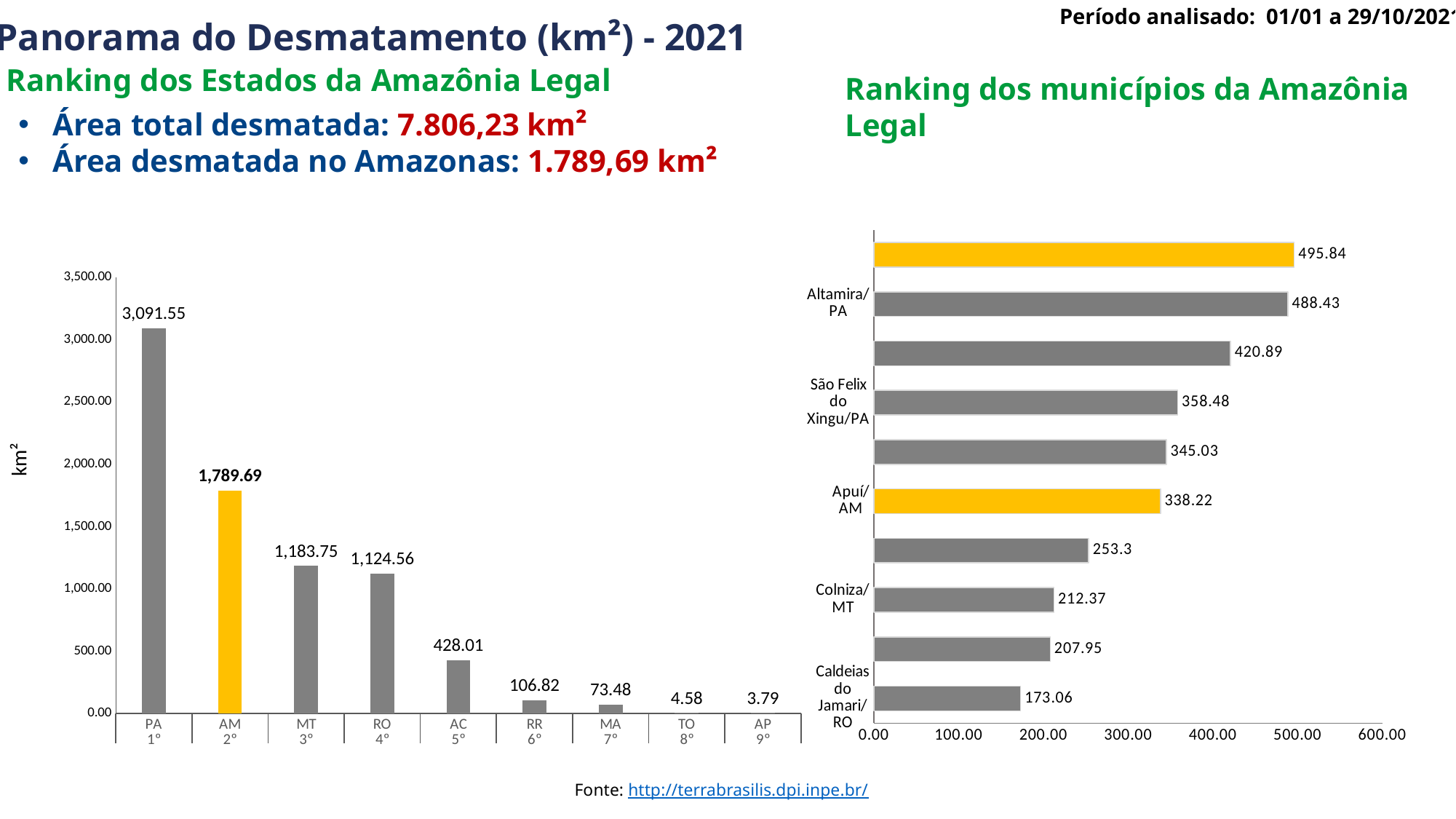
In the 'Ranking dos Estados da Amazônia Legal' chart, how many states are shown? 9 In the 'Ranking dos municípios da Amazônia Legal' chart, what is the value for Apuí/AM? 338.22 In the 'Ranking dos Estados da Amazônia Legal' chart, what is the value for PA? 3,091.55 In the 'Ranking dos Estados da Amazônia Legal' chart, which is larger, the value for MT or the value for RO? MT In the 'Ranking dos Estados da Amazônia Legal' chart, what is the difference between the values for PA and AM? 1,301.86 In the 'Ranking dos Estados da Amazônia Legal' chart, do the values rise or fall from left to right along the x axis? fall What kind of chart is the 'Ranking dos municípios da Amazônia Legal' chart? bar chart In the 'Ranking dos Estados da Amazônia Legal' chart, what is the value for AM? 1,789.69 In the 'Ranking dos municípios da Amazônia Legal' chart, how many bars are shown? 10 In the 'Ranking dos municípios da Amazônia Legal' chart, what is the value for Altamira/PA? 488.43 In the 'Ranking dos Estados da Amazônia Legal' chart, which state has the lowest value? AP In the 'Ranking dos municípios da Amazônia Legal' chart, which municipality has the lowest value? Caldeias do Jamari/RO